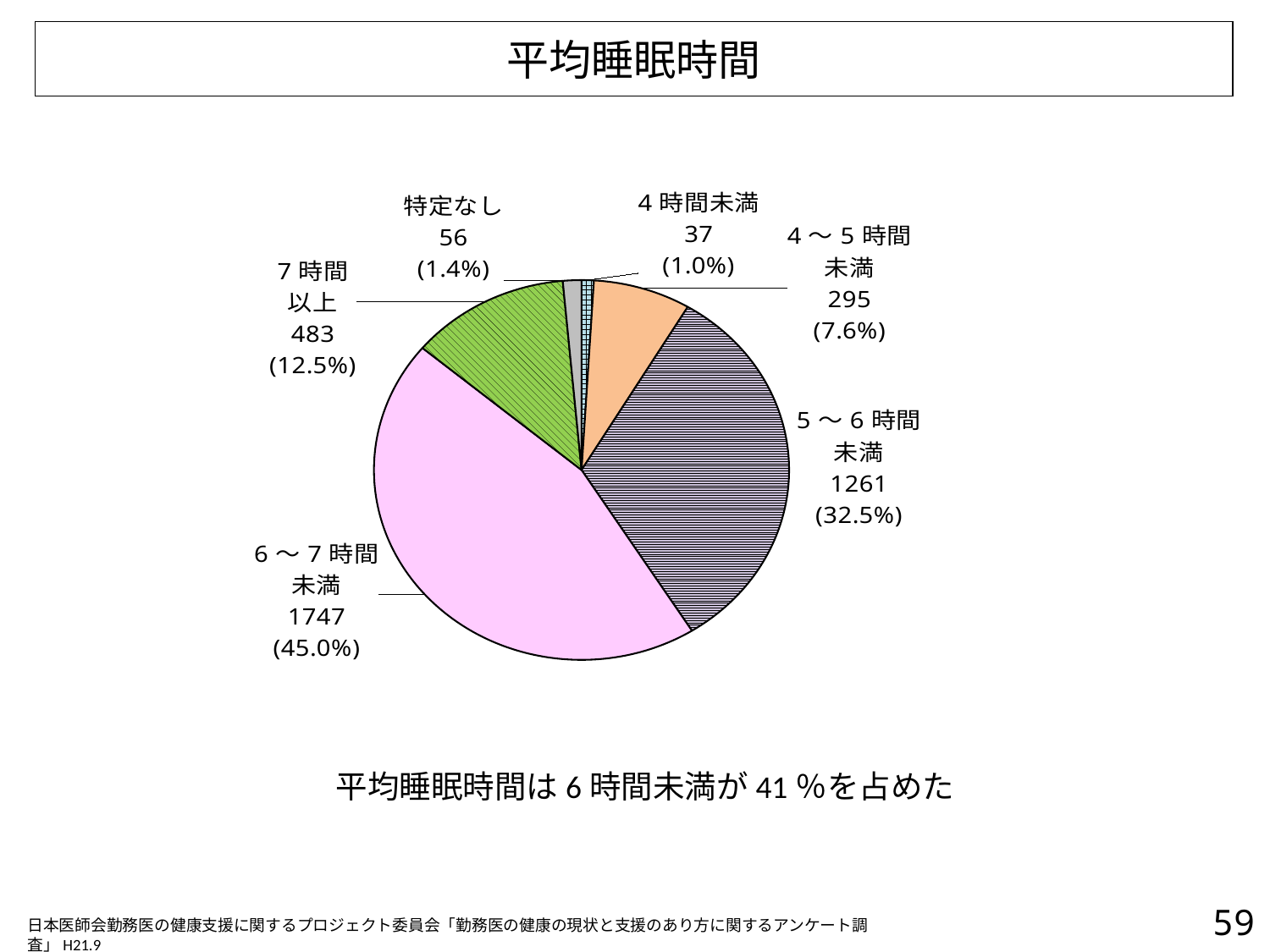
Which category has the smallest slice? 4時間未満 What is the difference in count between 6～7時間未満 and 5～6時間未満? 486 What is the count for 6～7時間未満? 1747 What kind of chart is shown on the slide? pie chart What percentage share does 4～5時間未満 have? 7.6% What percentage share does 特定なし have? 1.4% How many slices does the pie chart have? 6 What is the count for 7時間以上? 483 What is the count for 5～6時間未満? 1261 What is the title of the chart? 平均睡眠時間 Which category has the largest slice? 6～7時間未満 Which is larger, the count for 7時間以上 or the count for 4～5時間未満? 7時間以上